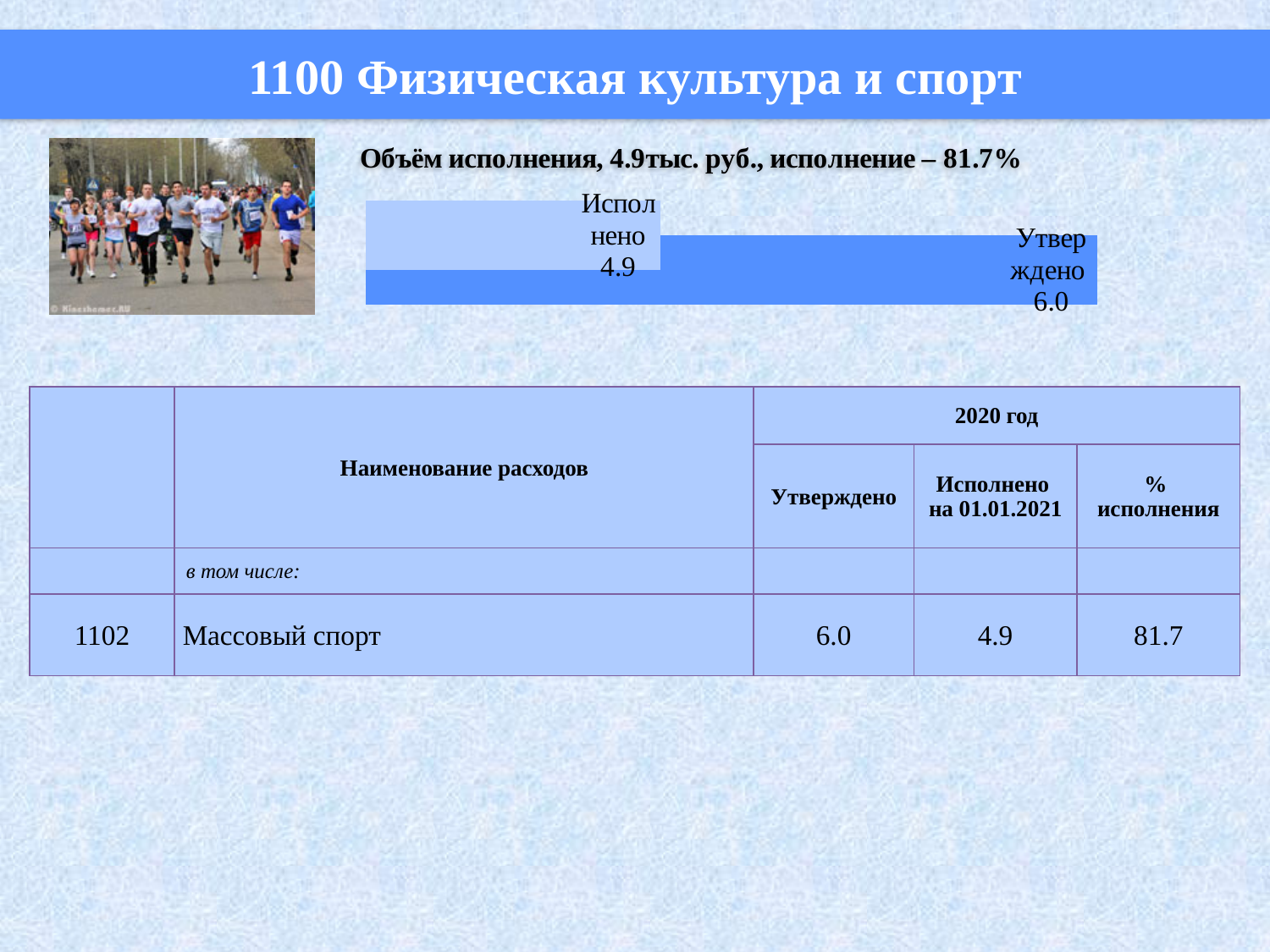
What is the difference between the "Утверждено" and "Исполнено" values in the chart? 1.1 Which bar has the higher value, "Исполнено" or "Утверждено"? Утверждено Which bar is drawn in the lighter blue colour, "Исполнено" or "Утверждено"? Исполнено How many bars are plotted in the chart? 2 What type of chart is shown on the slide? bar chart What is the value of the bar labelled "Утверждено"? 6.0 Which bar in the chart has the highest value? Утверждено What is the value of the bar labelled "Исполнено"? 4.9 Which bar in the chart has the lowest value? Исполнено What percentage of execution (исполнение) is stated in the text above the chart? 81.7%